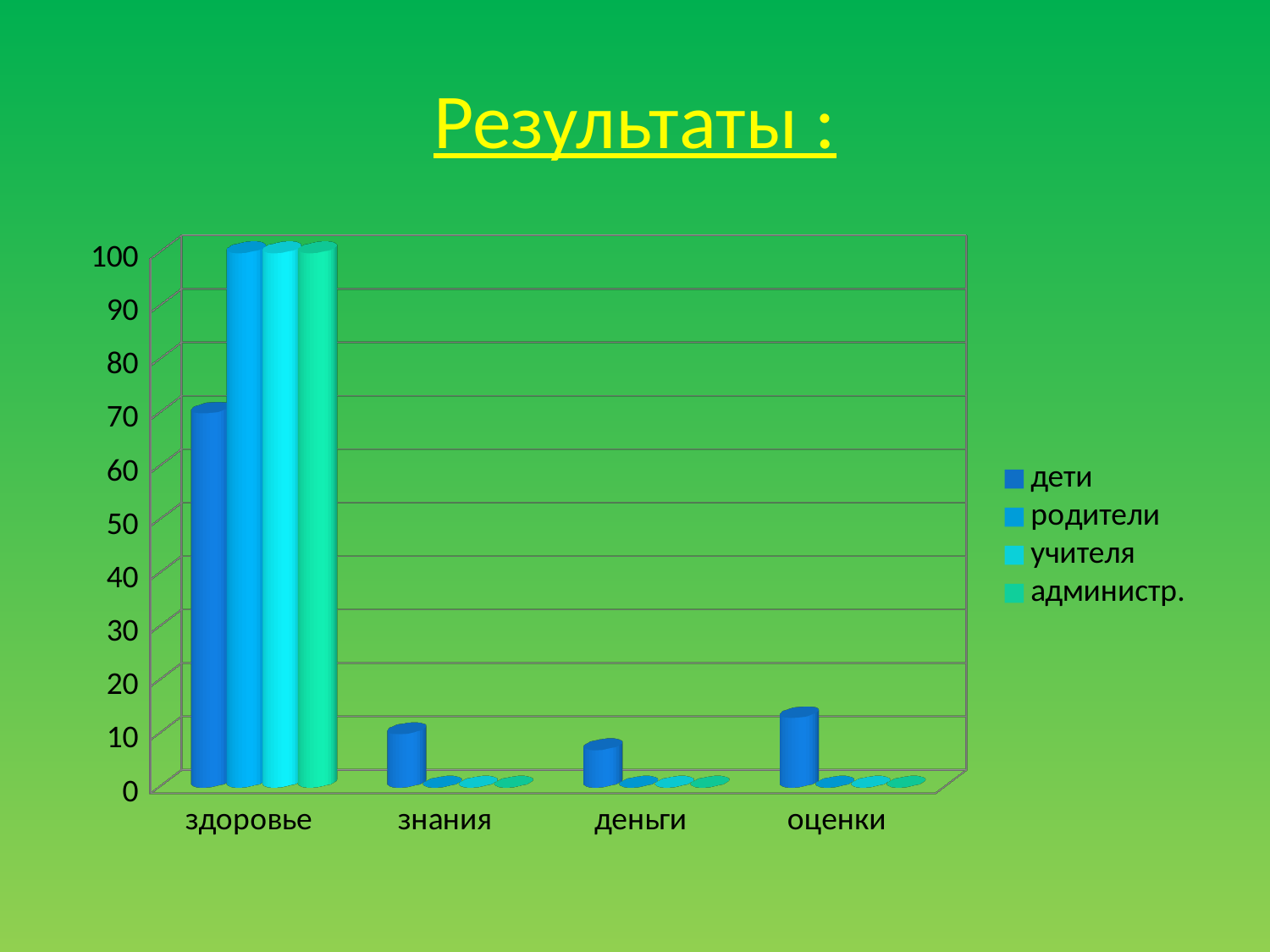
What kind of chart is shown on the slide? bar chart Which series is listed last in the legend? администр. Which category has the lowest value for the дети series? деньги For the дети series, which is larger: the value for знания or the value for оценки? оценки What is the value for учителя in the здоровье category? 100 What is the title of the slide above the chart? Результаты : How many categories are shown on the x axis? 4 How many series does the legend list? 4 What is the value for родители in the здоровье category? 100 Which category has the highest value for the дети series? здоровье Is the value for дети in the здоровье category greater or less than 60? greater Is the value for дети in the здоровье category greater or less than 80? less